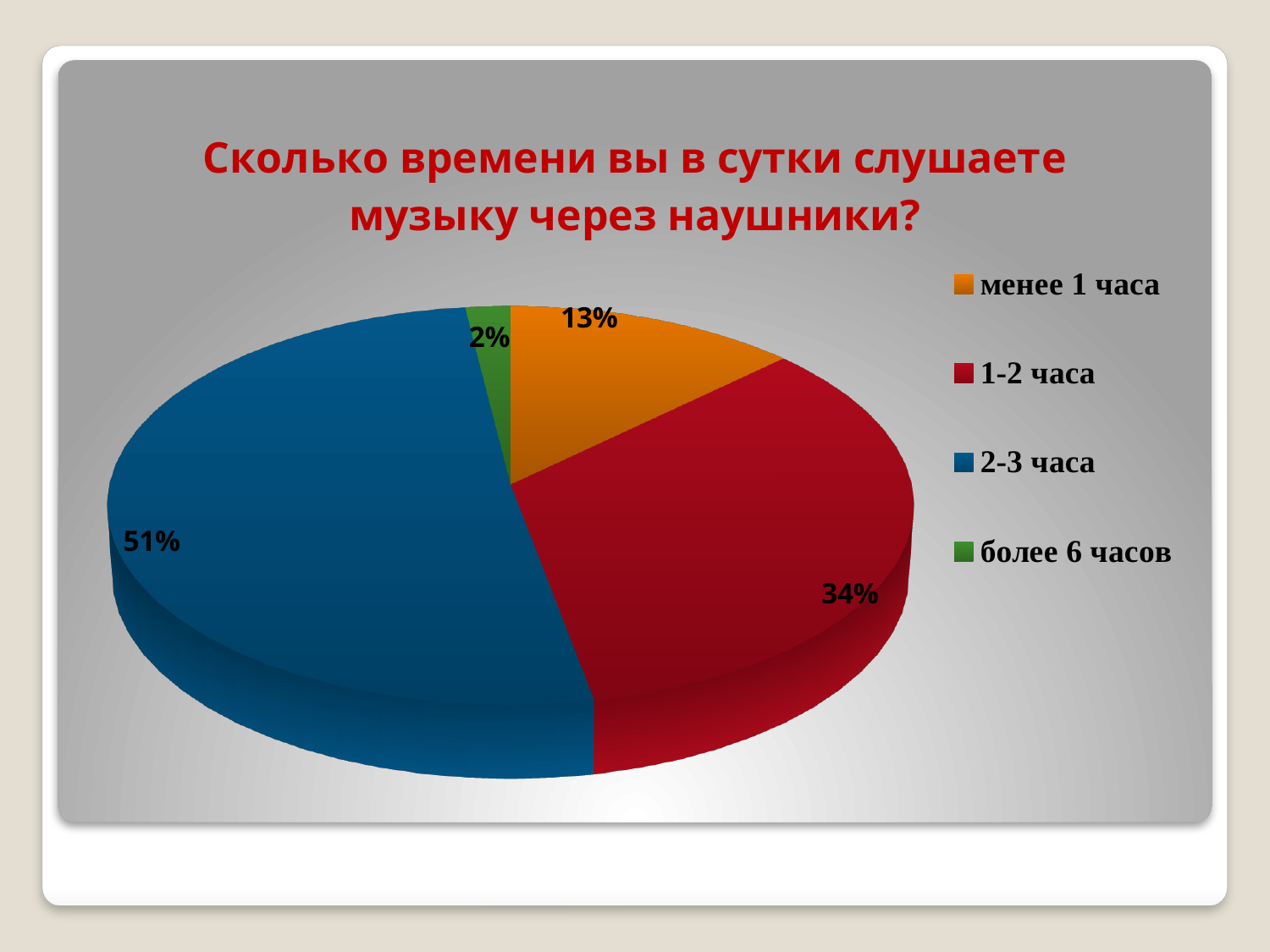
What is the value shown for 'менее 1 часа'? 13% Which is larger, the slice for 'менее 1 часа' or the slice for '1-2 часа'? 1-2 часа What is the title of the chart? Сколько времени вы в сутки слушаете музыку через наушники? Which category has the smallest slice? более 6 часов What kind of chart is shown on the slide? Pie chart What is the difference between the '2-3 часа' and '1-2 часа' slices? 17% Which category has the largest slice? 2-3 часа What is the value shown for 'более 6 часов'? 2% What share of the pie does the '2-3 часа' slice take? 51% What colour is the slice for '2-3 часа'? Blue How many categories does the pie chart show? 4 What is the value shown for '1-2 часа'? 34%